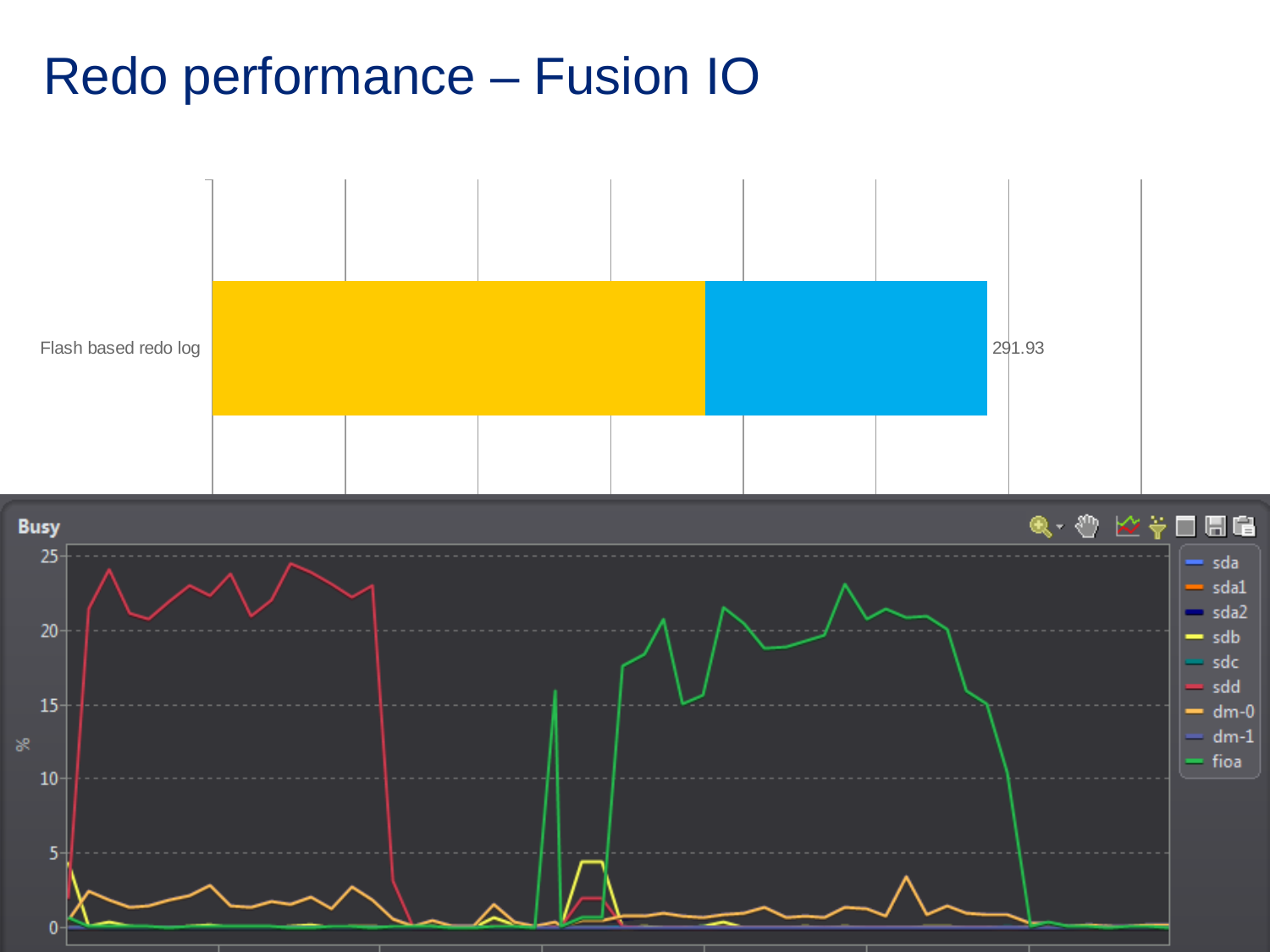
On the 'Busy' chart, which series reaches the highest value, sdd or dm-0? sdd How many categories does the top bar chart show? 1 What kind of chart is the top chart on the slide? bar chart On the 'Busy' chart, is the peak value of the fioa series greater or less than 20? greater On the 'Busy' chart, is the peak value of the dm-0 series greater or less than 5? less On the 'Busy' chart, is the peak value of the sdd series greater or less than 20? greater On the top chart, how many coloured segments make up the 'Flash based redo log' bar? 2 How many series does the legend of the 'Busy' chart list? 9 On the top chart, which segment of the 'Flash based redo log' bar is longer, the yellow one or the blue one? yellow On the top chart, what is the total value shown for the 'Flash based redo log' bar? 291.93 What kind of chart is the bottom chart titled 'Busy'? line chart What is the unit label on the y axis of the 'Busy' chart? %